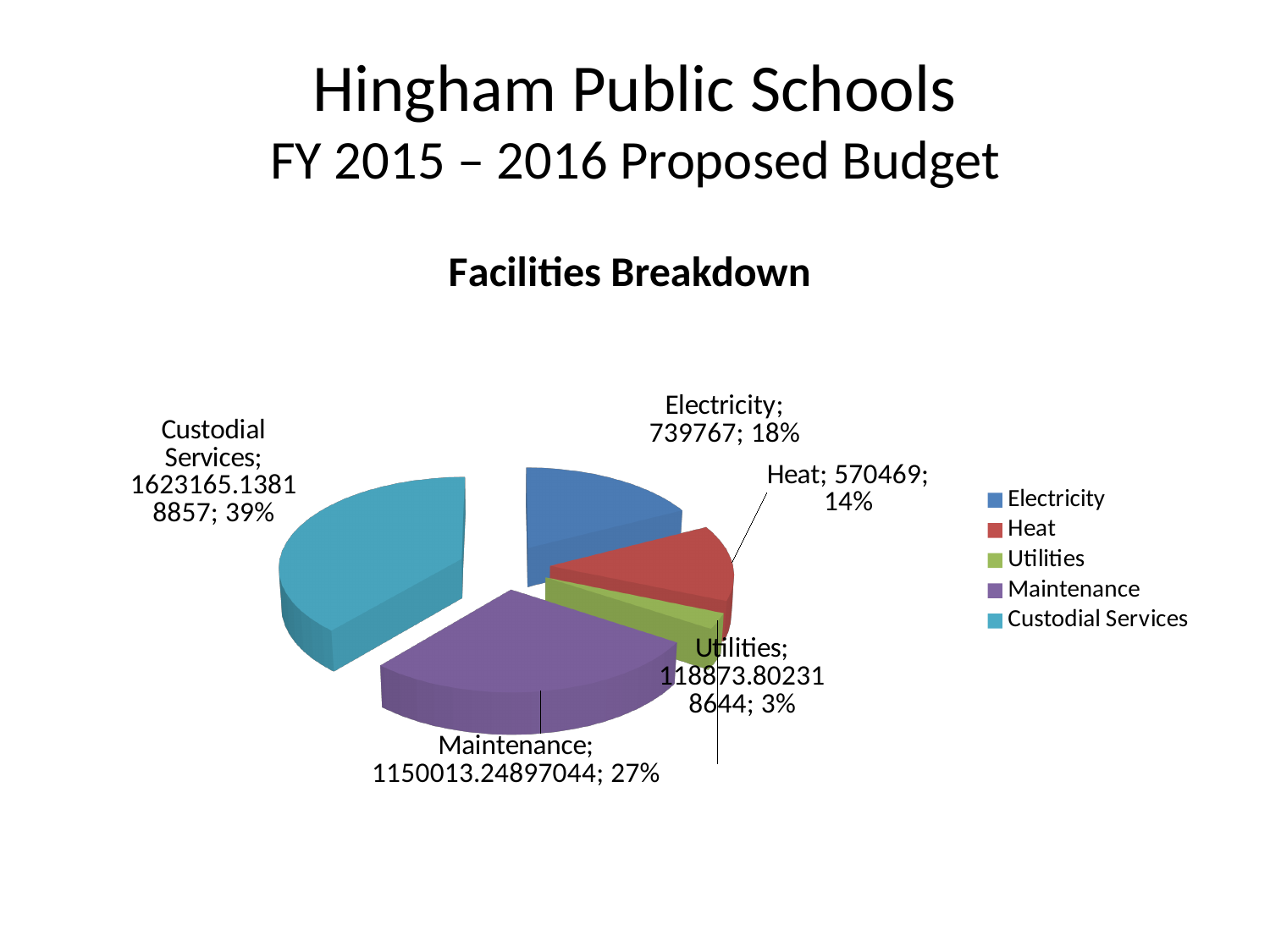
What is the value for Heat? 570469 What is the title of the chart? Facilities Breakdown What kind of chart is shown on the slide? pie chart How many entries does the legend list? 5 What is the value for Electricity? 739767 What is the value for Maintenance? 1150013.24897044 Which category has the smallest slice? Utilities What share of the pie does Custodial Services represent? 39% How many slices does the pie chart have? 5 Which category has the largest slice? Custodial Services What is the difference between the values for Electricity and Heat? 169298 What share of the pie does Utilities represent? 3%